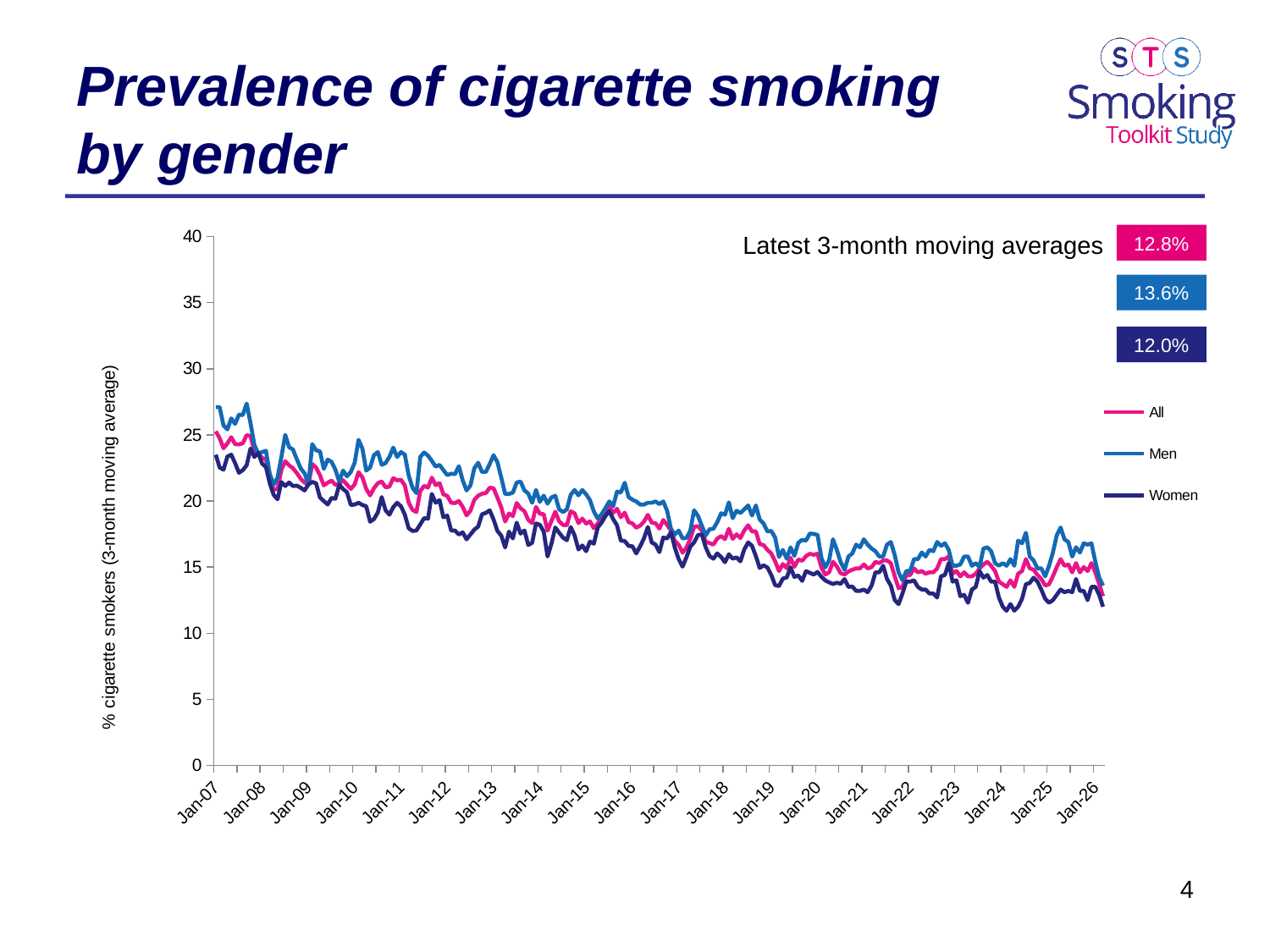
Which group has the highest latest 3-month moving average? Men What kind of chart is shown on the slide? Line chart How many series does the legend list? 3 What is the latest 3-month moving average for Men? 13.6% Is the value for Men at Jan-07 greater or less than 25? greater What is the label on the y axis? % cigarette smokers (3-month moving average) What is the difference between the latest 3-month moving averages for Men and Women? 1.6 percentage points What is the latest 3-month moving average for Women? 12.0% Do the smoking prevalence lines rise or fall from Jan-07 to Jan-26? Fall Which group has the lowest latest 3-month moving average? Women Is the latest 3-month moving average higher for Men or for All? Men What is the latest 3-month moving average for All? 12.8%